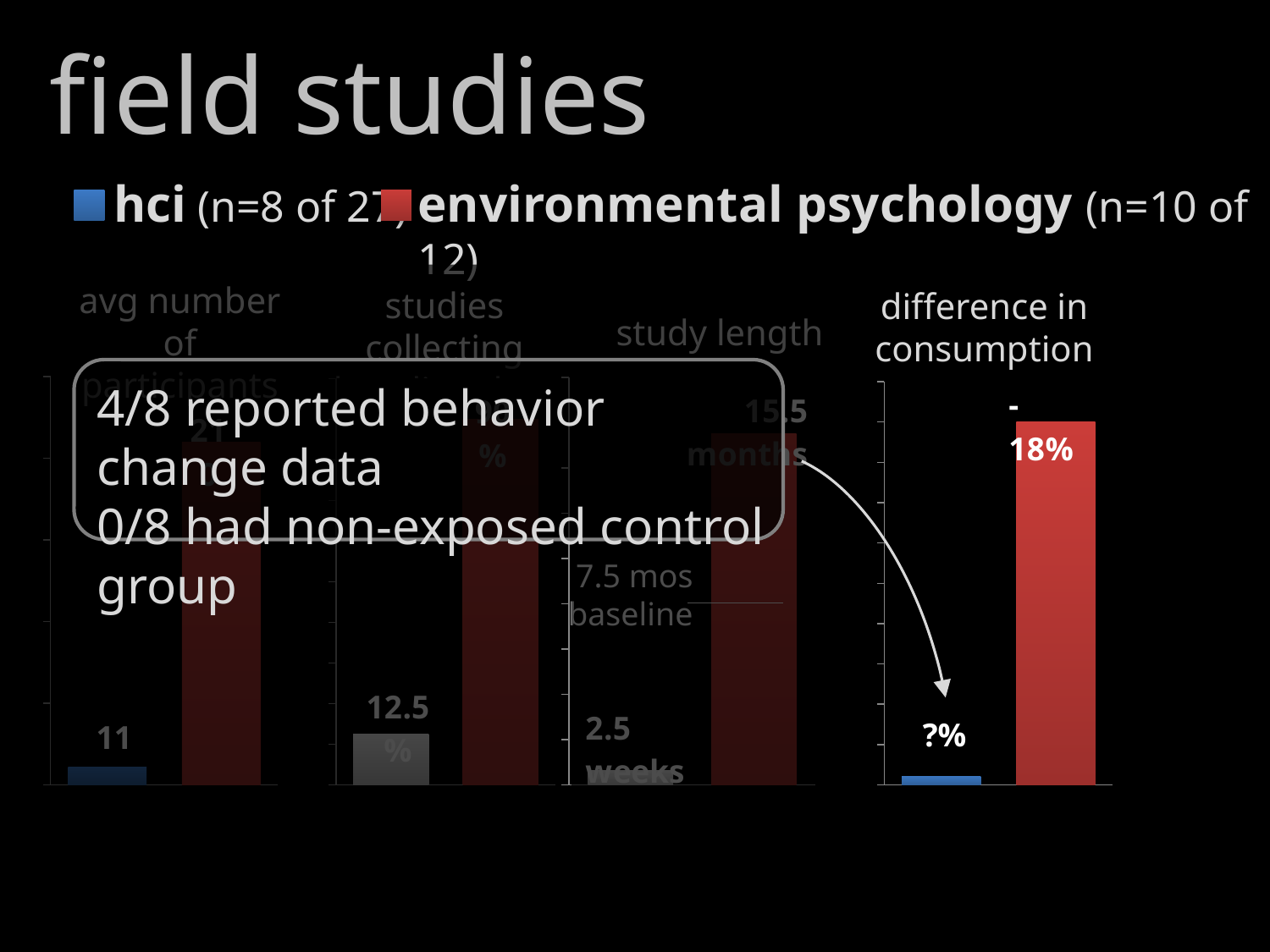
In the 'difference in consumption' chart, what label is shown for hci? ?% In the 'difference in consumption' chart, what is the value for environmental psychology? -18% How many series does the legend list? 2 In the 'study length' chart, what is the value for environmental psychology? 15.5 months In the 'avg number of participants' chart, which field has the higher average number of participants? environmental psychology Which colour represents environmental psychology in the charts? red In the 'study length' chart, what is the value for hci? 2.5 weeks In the 'studies collecting' chart, what is the value for hci? 12.5% In the 'avg number of participants' chart, what is the value for hci? 11 How many bars are in the 'difference in consumption' chart? 2 In the 'study length' chart, which field has the longer study length, hci or environmental psychology? environmental psychology What kind of chart is the 'difference in consumption' chart? bar chart